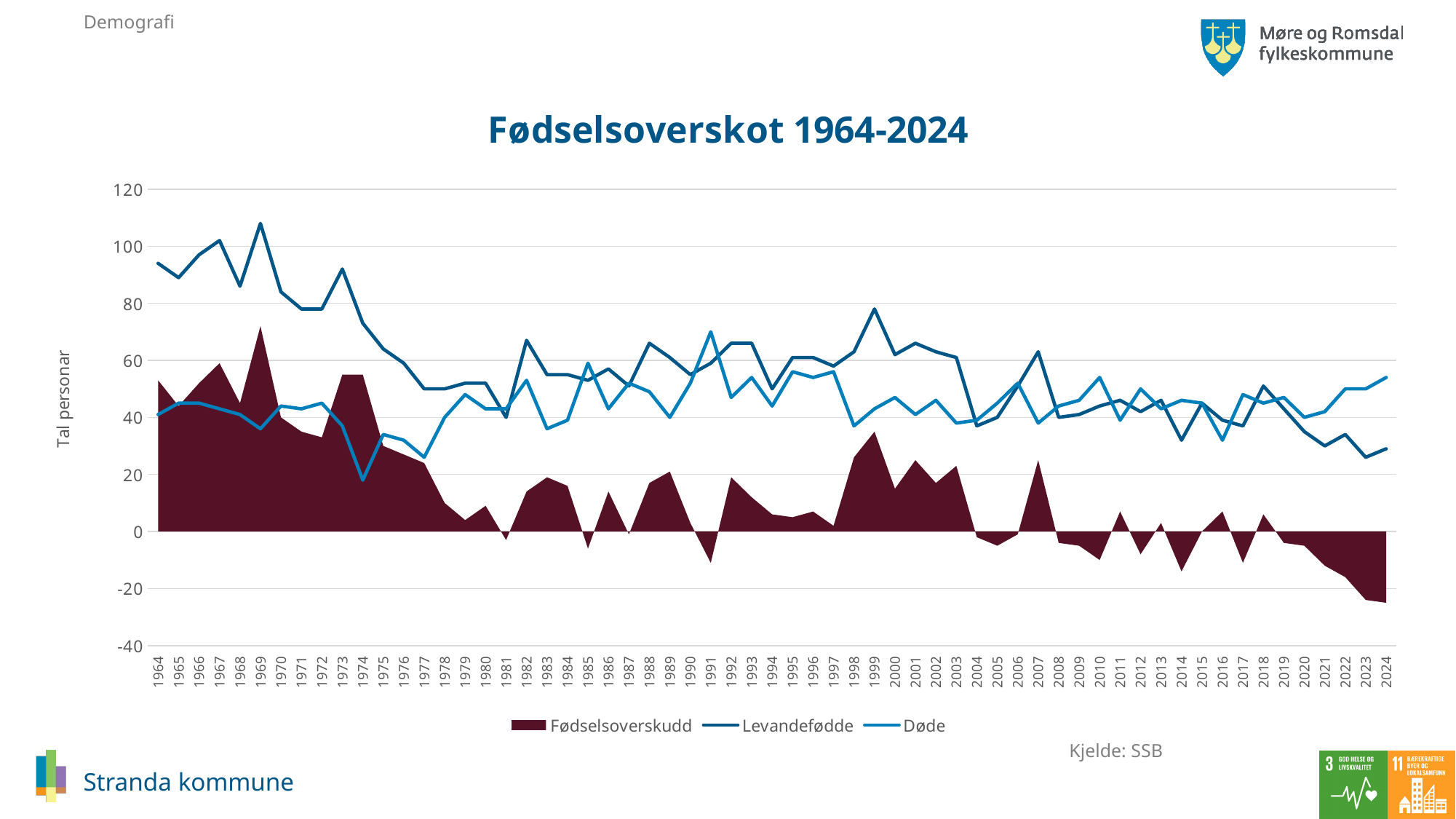
Is the value for Fødselsoverskudd in 2024 greater or less than -20? less What is the title of the chart? Fødselsoverskot 1964-2024 In 2024, which is larger: Levandefødde or Døde? Døde In 1964, which is larger: Levandefødde or Døde? Levandefødde How many series does the chart legend list? 3 Is the value for Levandefødde in 2023 greater or less than 40? less Is the value for Døde in 1991 greater or less than 60? greater How many years are plotted along the x axis of the chart? 61 What is the label on the vertical axis of the chart? Tal personar In which year does the Levandefødde series reach its highest value? 1969